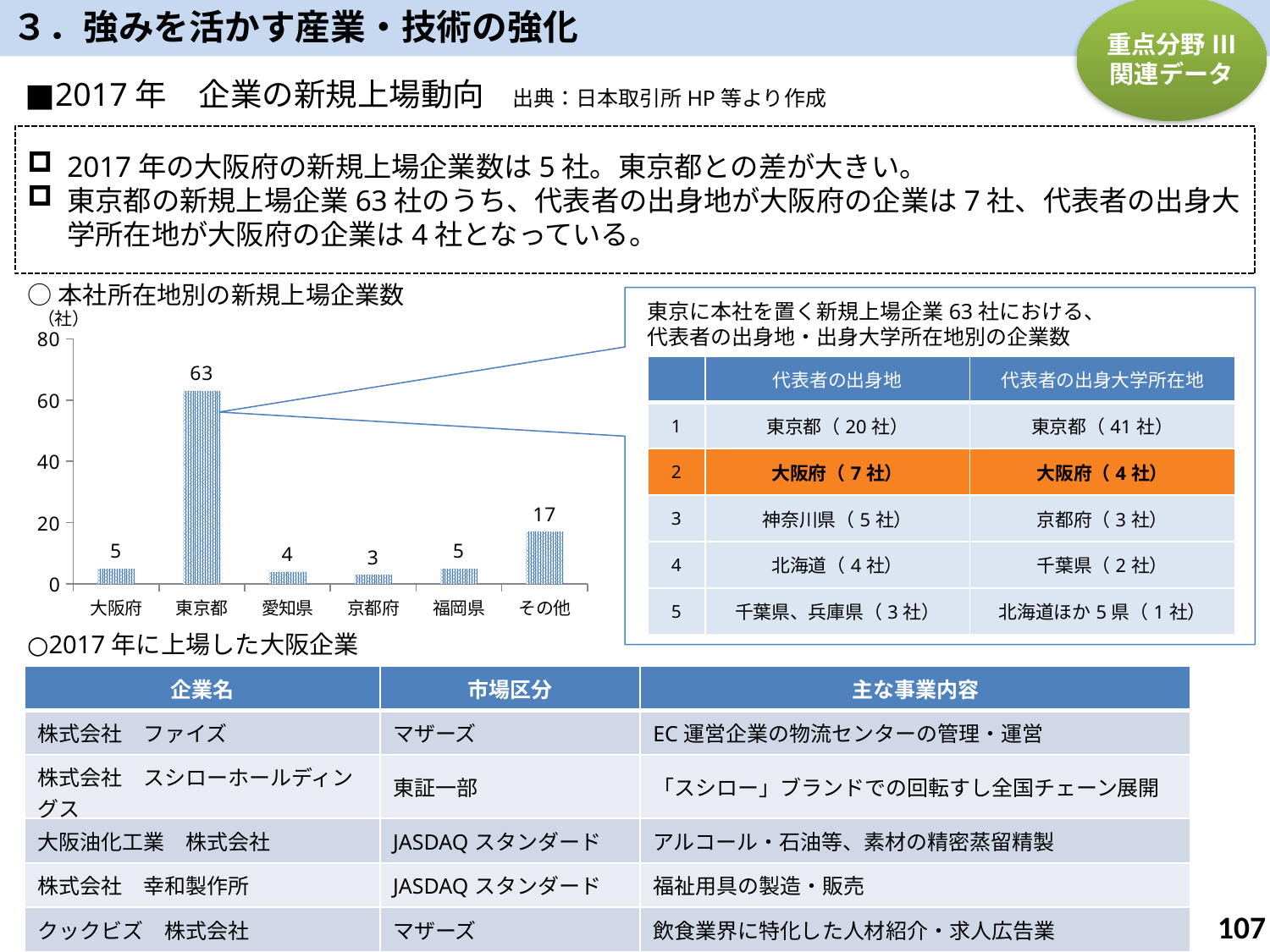
What is the value for その他 in the bar chart 本社所在地別の新規上場企業数? 17 How many categories are shown on the x axis of the bar chart 本社所在地別の新規上場企業数? 6 What is the value for 京都府 in the bar chart 本社所在地別の新規上場企業数? 3 In the bar chart 本社所在地別の新規上場企業数, what is the difference between the values for 東京都 and 大阪府? 58 What is the value for 大阪府 in the bar chart 本社所在地別の新規上場企業数? 5 Which category has the highest value in the bar chart 本社所在地別の新規上場企業数? 東京都 What kind of chart is 本社所在地別の新規上場企業数? bar chart Which category has the lowest value in the bar chart 本社所在地別の新規上場企業数? 京都府 In the bar chart 本社所在地別の新規上場企業数, is the value for 東京都 greater or less than 40? greater In the bar chart 本社所在地別の新規上場企業数, which is larger, the value for 愛知県 or the value for その他? その他 What is the value for 東京都 in the bar chart 本社所在地別の新規上場企業数? 63 What unit is shown on the y axis of the bar chart 本社所在地別の新規上場企業数? 社